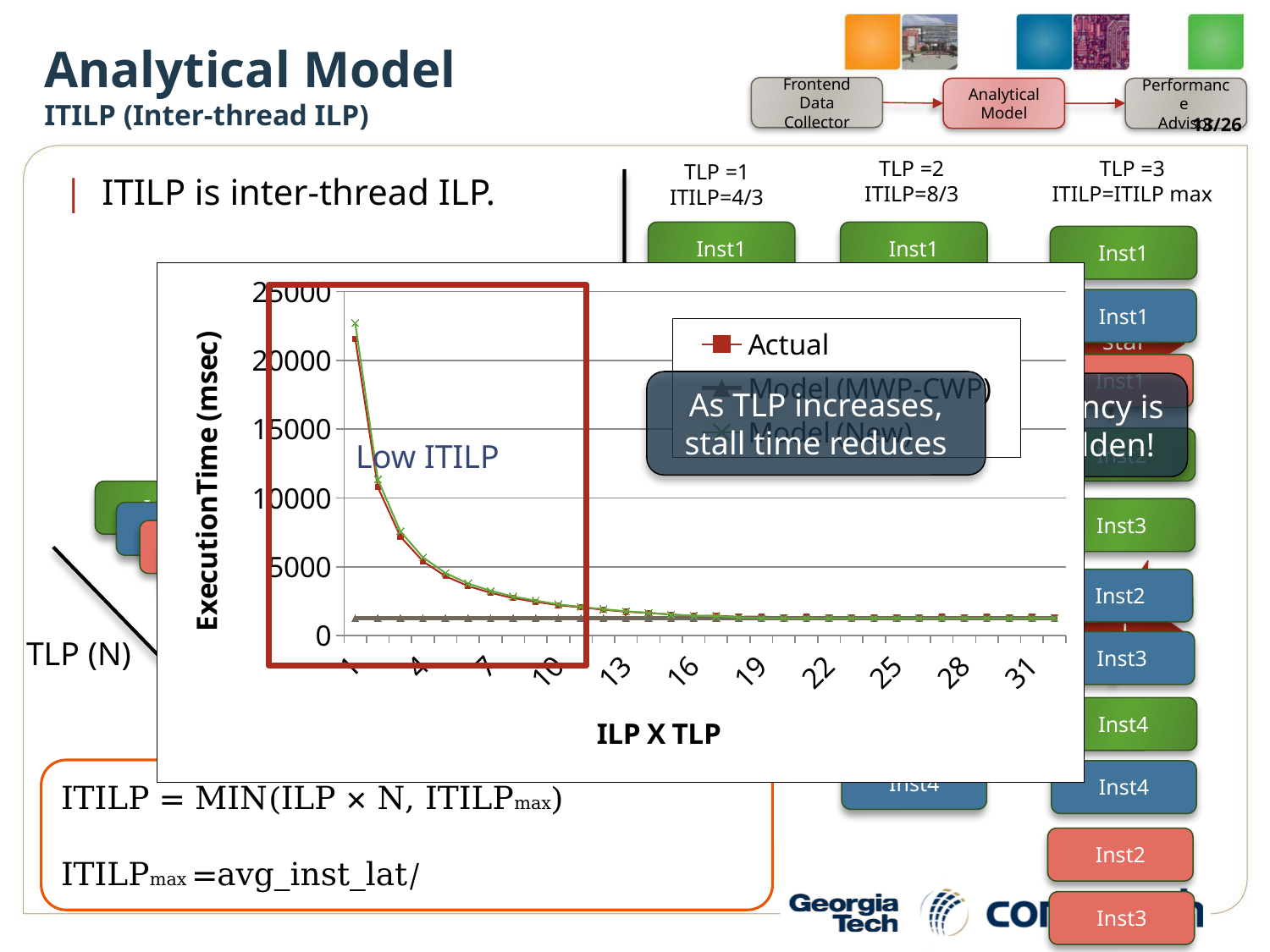
Is the Actual execution time at ILP X TLP = 13 greater or less than 5000? less Does the Actual execution time rise or fall as ILP X TLP increases? fall What kind of chart is shown on the slide? line chart What is the title of the y axis of the chart? ExecutionTime (msec) How many series does the chart's legend list? 3 Is the Actual execution time at ILP X TLP = 1 greater or less than 20000? greater Is the Actual execution time at ILP X TLP = 4 greater or less than 10000? less At ILP X TLP = 1, which is larger: the Actual execution time or the Model (MWP-CWP) execution time? Actual What is the highest value shown on the y axis of the chart? 25000 What is the title of the x axis of the chart? ILP X TLP